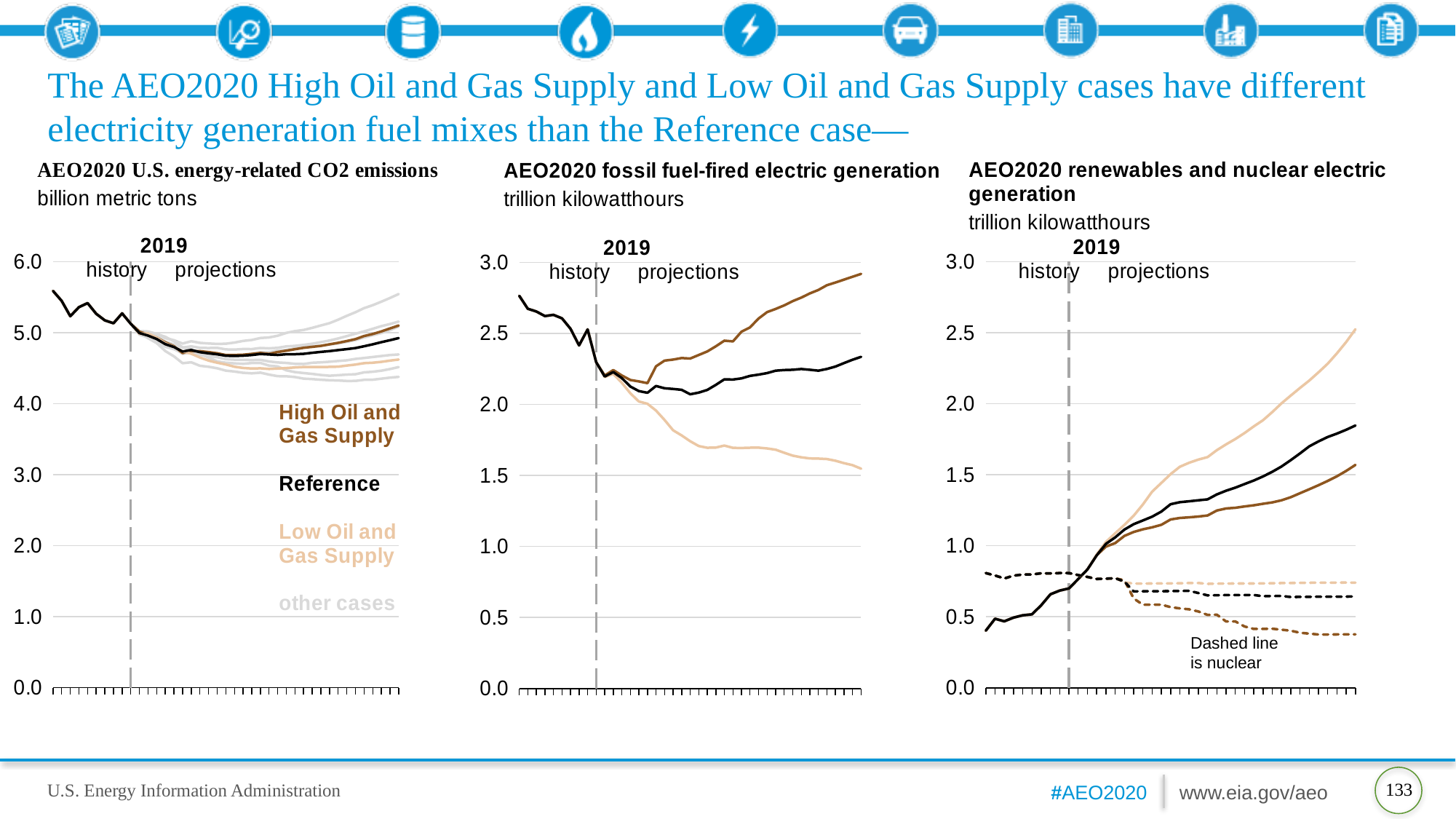
In the AEO2020 fossil fuel-fired electric generation chart, does the High Oil and Gas Supply line rise or fall over the projection period? rise In the AEO2020 fossil fuel-fired electric generation chart, does the Low Oil and Gas Supply line rise or fall over the projection period? fall In the AEO2020 renewables and nuclear electric generation chart, does the solid Low Oil and Gas Supply line rise or fall over the projection period? rise In the AEO2020 fossil fuel-fired electric generation chart, is the High Oil and Gas Supply value at the end of the projection period greater or less than 2.5? greater In the AEO2020 fossil fuel-fired electric generation chart, which case is higher at the end of the projection period, High Oil and Gas Supply or Low Oil and Gas Supply? High Oil and Gas Supply In the AEO2020 fossil fuel-fired electric generation chart, is the Low Oil and Gas Supply value at the end of the projection period greater or less than 2.0? less In the AEO2020 fossil fuel-fired electric generation chart, which year separates history from projections? 2019 In the AEO2020 renewables and nuclear electric generation chart, which case has higher renewable generation at the end of the projection period, Reference or High Oil and Gas Supply? Reference What kind of chart is the AEO2020 U.S. energy-related CO2 emissions chart? line chart In the AEO2020 renewables and nuclear electric generation chart, what do the dashed lines represent? nuclear In the AEO2020 U.S. energy-related CO2 emissions chart, is the Reference case value at the end of the projection period greater or less than 4.0? greater